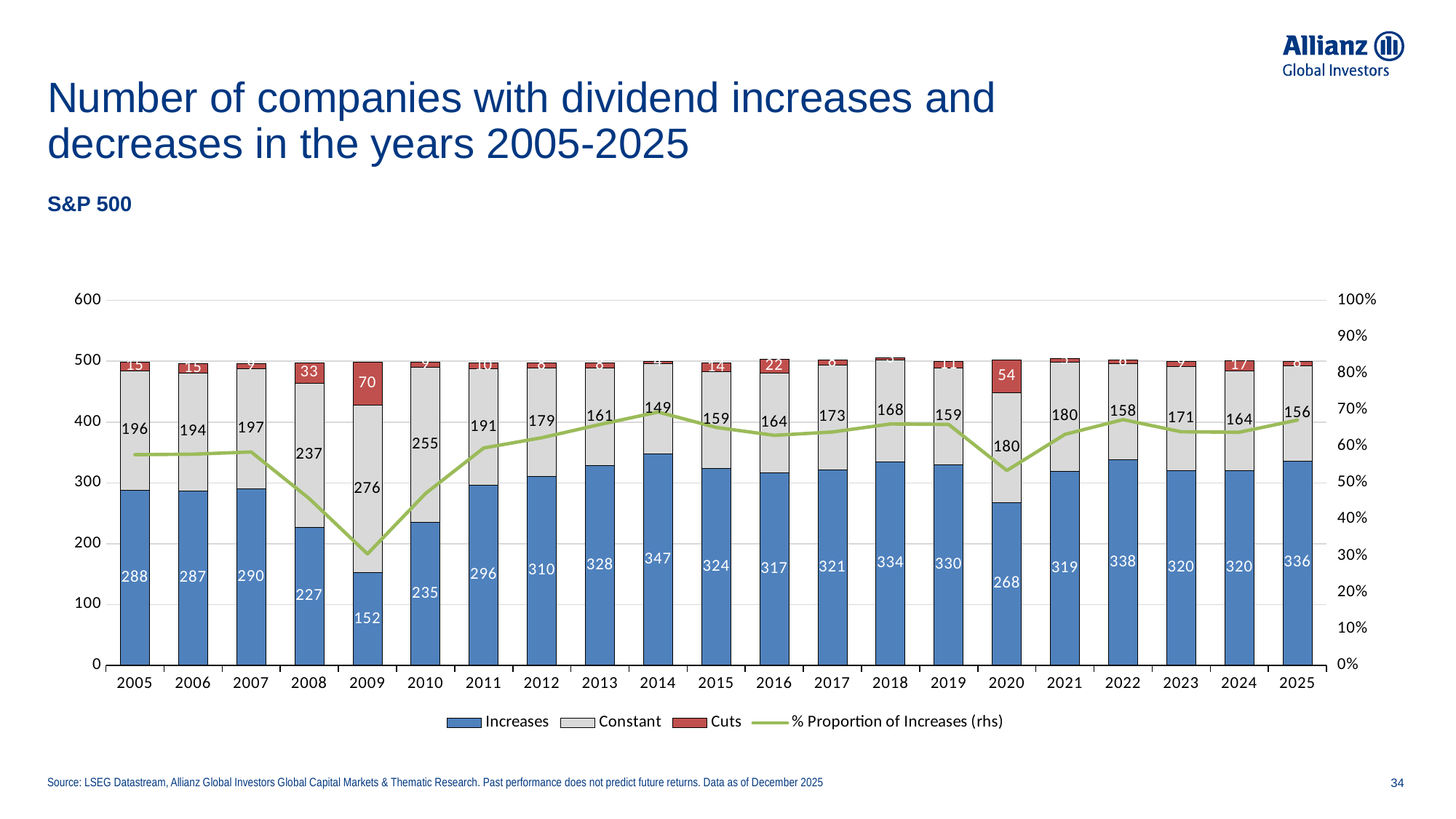
Which year had more dividend increases, 2020 or 2021? 2021 What is the total height of the stacked bar for 2009 (Increases + Constant + Cuts)? 498 How many years are shown on the x axis of the chart? 21 Is the % Proportion of Increases for 2009 greater or less than 40%? less What is the value of the Constant series for 2009? 276 How many series does the chart legend list? 4 In which year was the number of dividend increases the highest? 2014 In which year was the number of dividend increases the lowest? 2009 In which year was the number of dividend cuts the highest? 2009 How many dividend cuts are shown for 2020? 54 How many companies had dividend increases in 2014? 347 What is the difference between the number of dividend increases in 2014 and in 2009? 195